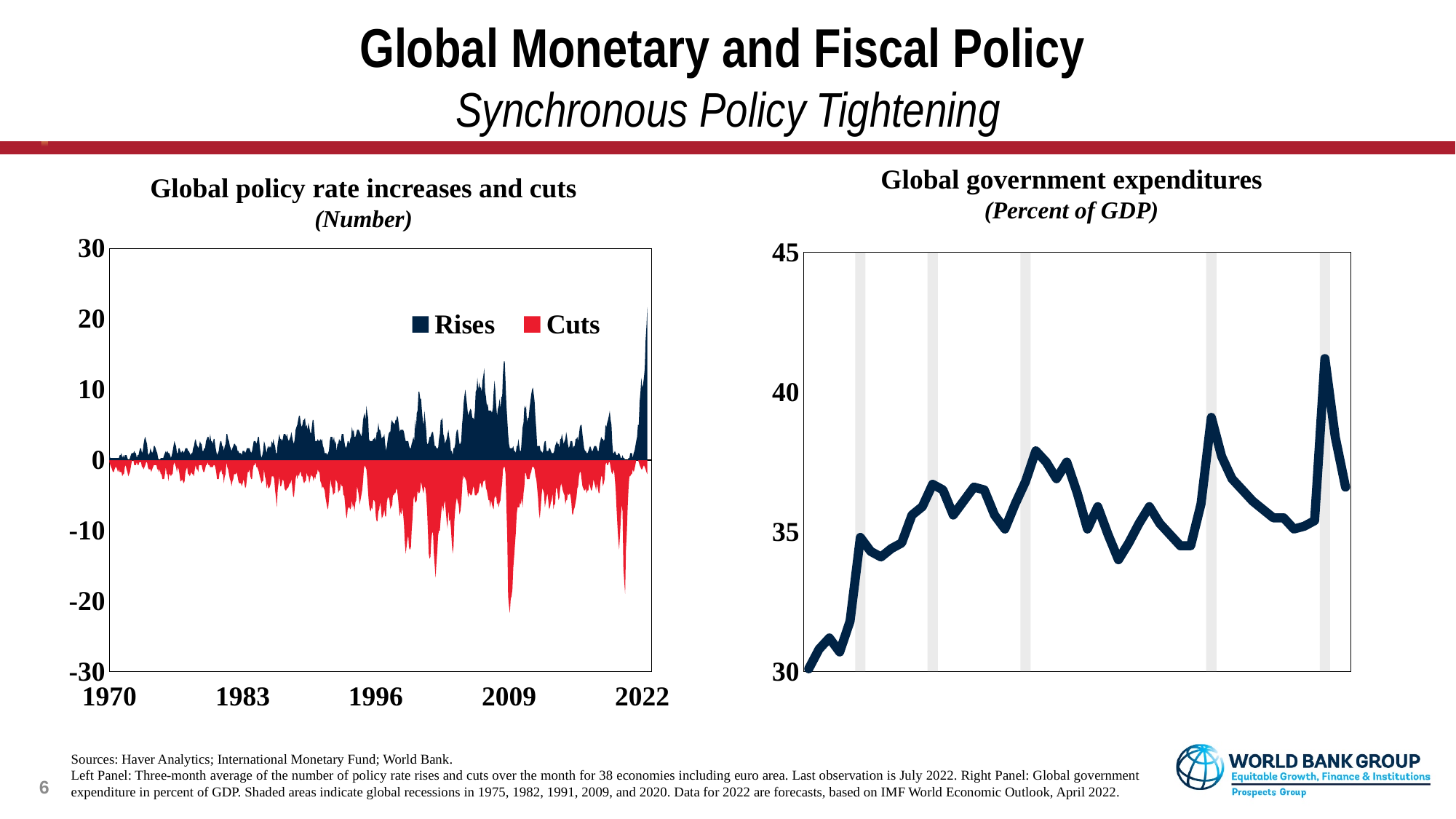
In the right chart, 'Global government expenditures', is the value at the right end of the line greater or less than 40? less What kind of chart is the left chart, 'Global policy rate increases and cuts'? area chart In the left chart, 'Global policy rate increases and cuts', which series is shown in dark navy? Rises How many shaded recession bands are shown in the right chart, 'Global government expenditures'? 5 In the left chart, 'Global policy rate increases and cuts', is the deepest value for cuts around 2009 greater or less than -10? less In the right chart, 'Global government expenditures', is the peak value in the last shaded recession band greater or less than 40? greater In the left chart, 'Global policy rate increases and cuts', which series is shown in red? Cuts What kind of chart is the right chart, 'Global government expenditures'? line chart In the right chart, 'Global government expenditures', does the line overall rise or fall from its left end to its right end? rise How many series does the legend of the left chart, 'Global policy rate increases and cuts', list? 2